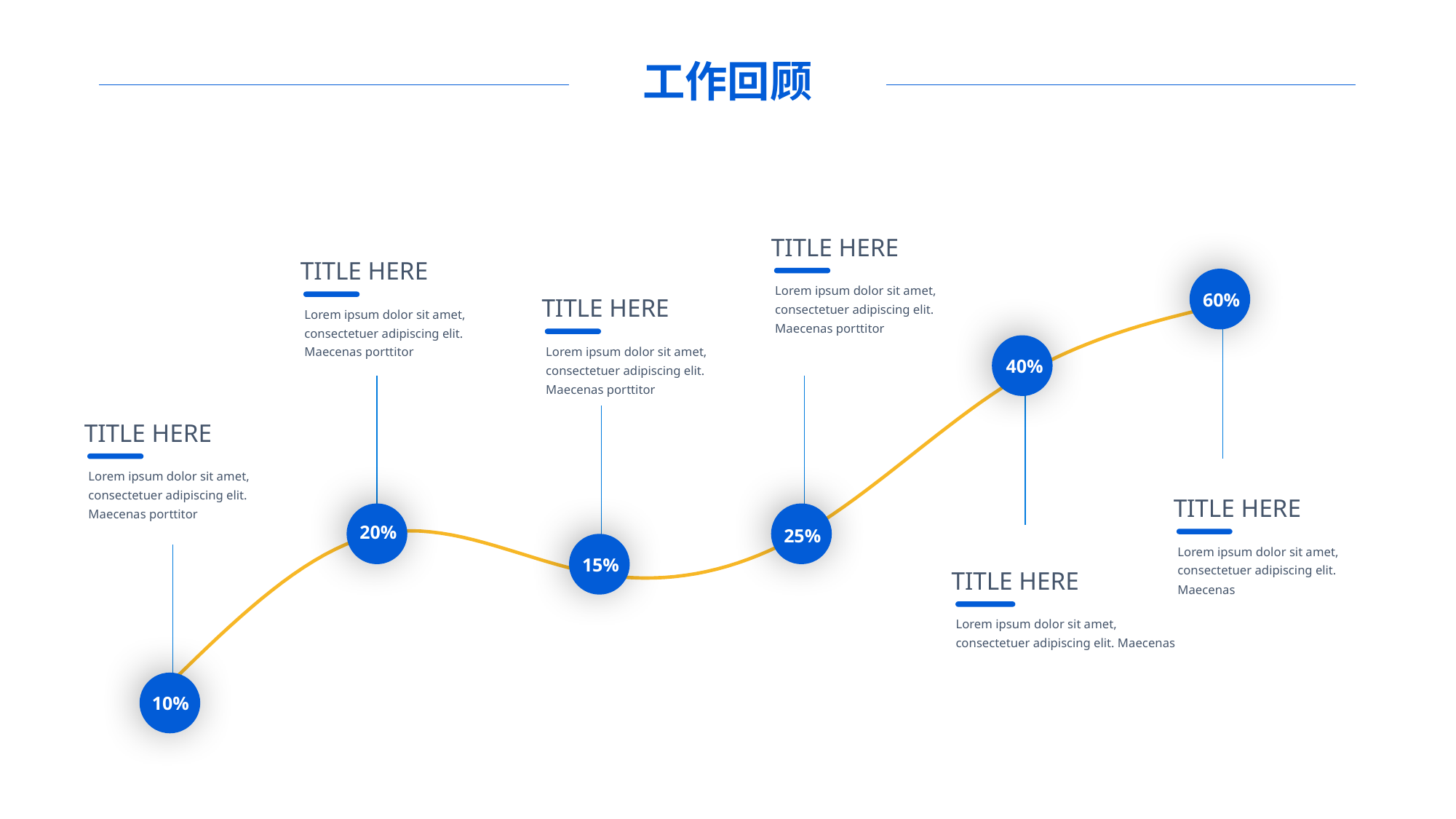
What is the value of the last (rightmost) point on the line? 60% What is the value of the second point from the left on the line? 20% Which is larger, the second point or the third point on the line? the second point (20%) What is the highest value shown on the line? 60% How many data points are plotted on the line? 6 What is the lowest value shown on the line? 10% Overall, do the values rise or fall from left to right along the line? rise What is the value of the third point from the left on the line? 15% What is the value of the first (leftmost) point on the line? 10% What is the difference between the fifth point (40%) and the fourth point (25%)? 15% What is the title of the slide? 工作回顾 What kind of chart is shown on the slide? line chart